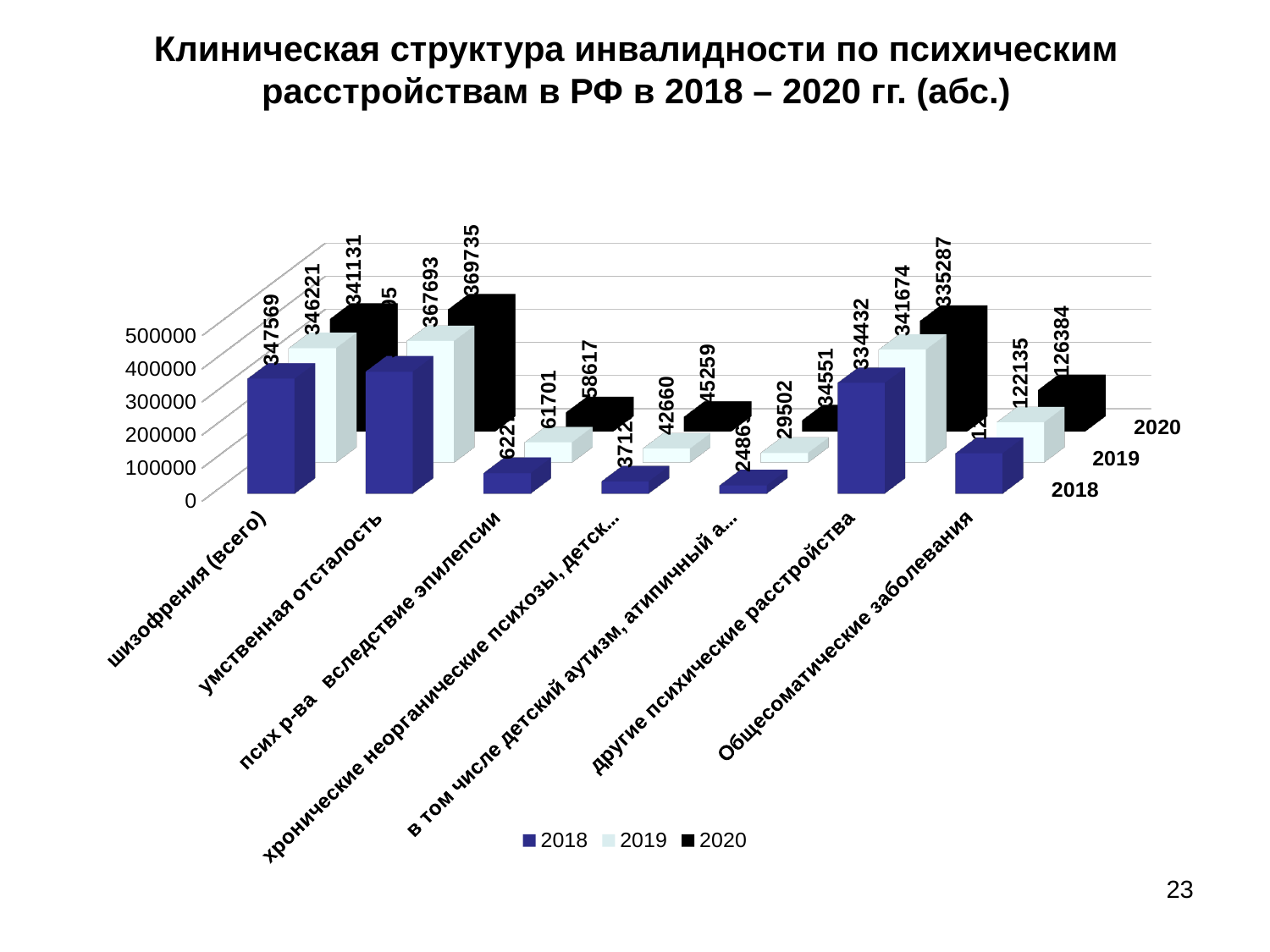
What is the value for Общесоматические заболевания in 2020? 126384 What is the value for шизофрения (всего) in 2018? 347569 What is the value for другие психические расстройства in 2019? 341674 Which is larger for умственная отсталость: the 2019 value or the 2020 value? 2020 Which category has the highest value in the 2020 series? умственная отсталость What kind of chart is shown on the slide? bar chart Which category has the lowest value in the 2019 series? в том числе детский аутизм, атипичный а... What is the difference between the 2020 and 2019 values for Общесоматические заболевания? 4249 What is the difference between the 2018 and 2020 values for шизофрения (всего)? 6438 How many series does the legend list? 3 How many categories are shown on the x axis? 7 What is the value for умственная отсталость in 2020? 369735